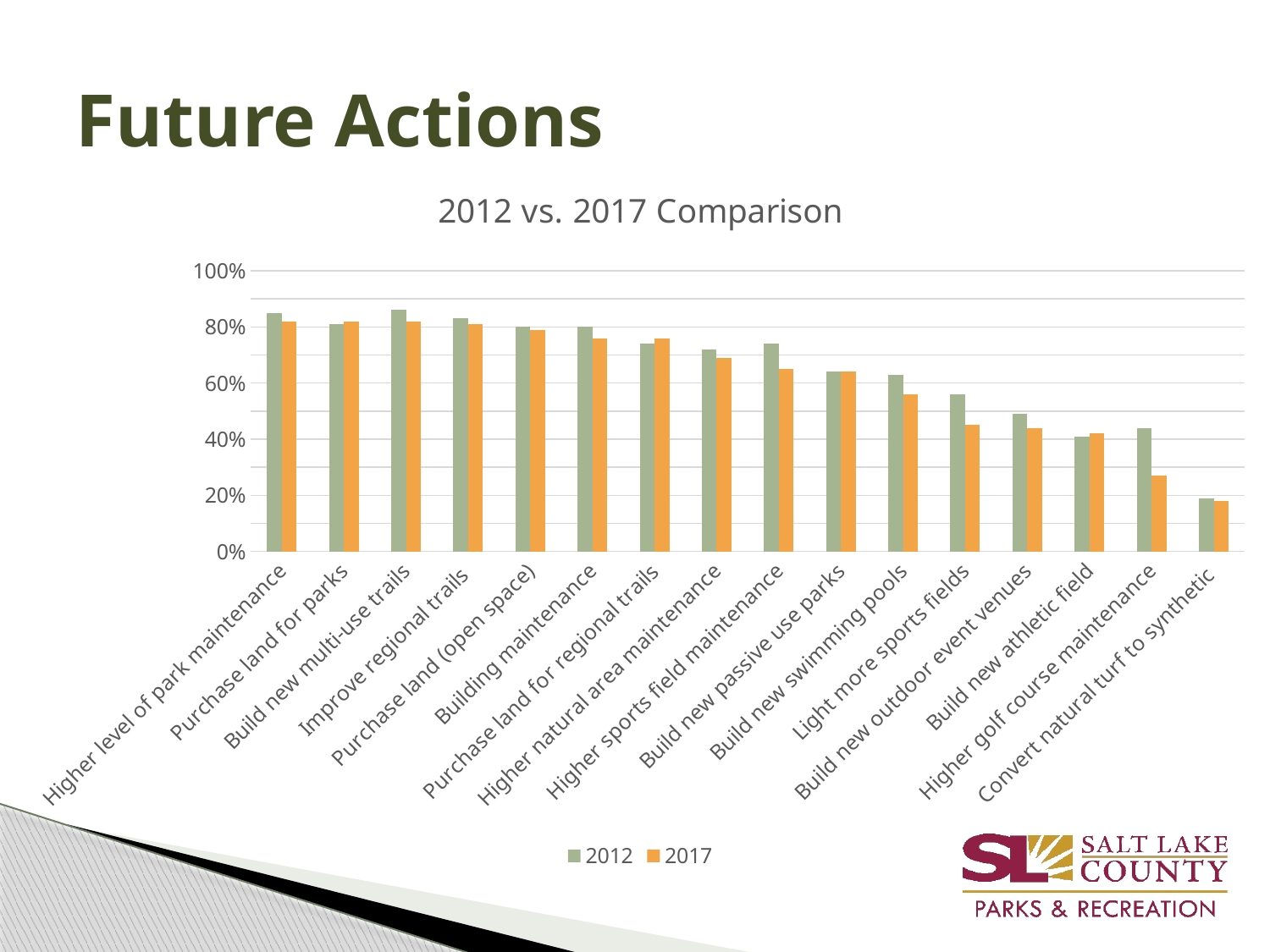
Do the 2012 values generally rise or fall moving from left to right along the x axis? fall Which category has the lowest value for 2012? Convert natural turf to synthetic How many series does the legend list? 2 What is the title of the chart? 2012 vs. 2017 Comparison Is the 2017 value for Higher golf course maintenance greater or less than 40%? less Is the 2012 value for Build new outdoor event venues greater or less than 60%? less Is the 2012 value for Convert natural turf to synthetic greater or less than 40%? less Which category has the lowest value for 2017? Convert natural turf to synthetic How many categories are shown on the x axis? 16 For Higher golf course maintenance, which series has the larger value, 2012 or 2017? 2012 What kind of chart is shown on the slide? bar chart